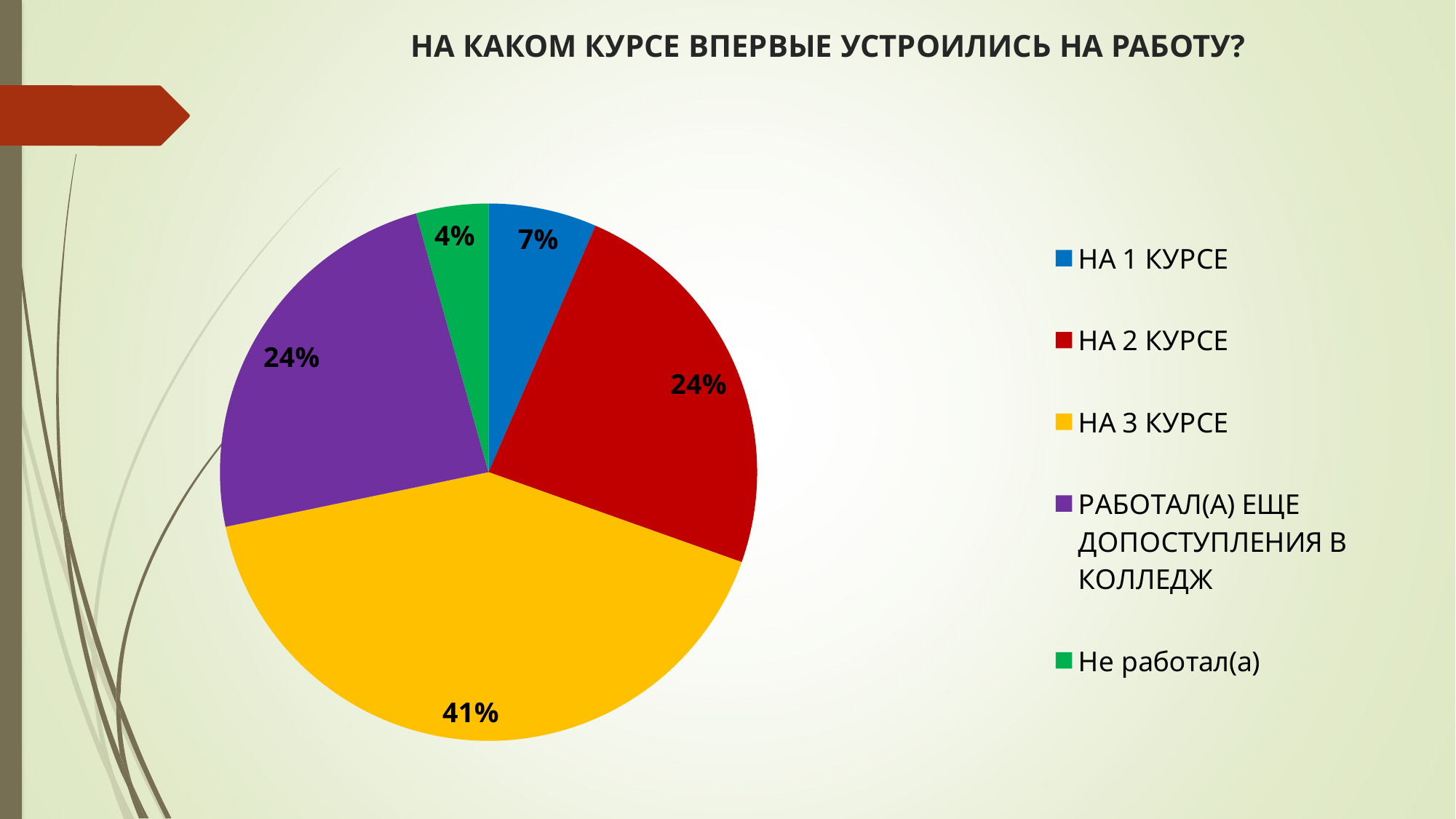
What share of the pie does "НА 1 КУРСЕ" have? 7% What colour is the slice for "НА 3 КУРСЕ"? yellow What share of the pie does "НА 2 КУРСЕ" have? 24% Which is larger, the share of "НА 1 КУРСЕ" or the share of "Не работал(а)"? НА 1 КУРСЕ What share of the pie does "НА 3 КУРСЕ" have? 41% What kind of chart is shown on the slide? pie chart What is the title of the chart? НА КАКОМ КУРСЕ ВПЕРВЫЕ УСТРОИЛИСЬ НА РАБОТУ? What is the difference between the shares of "НА 3 КУРСЕ" and "НА 2 КУРСЕ"? 17% Which category has the smallest slice of the pie? Не работал(а) Which category has the largest slice of the pie? НА 3 КУРСЕ How many categories does the legend list? 5